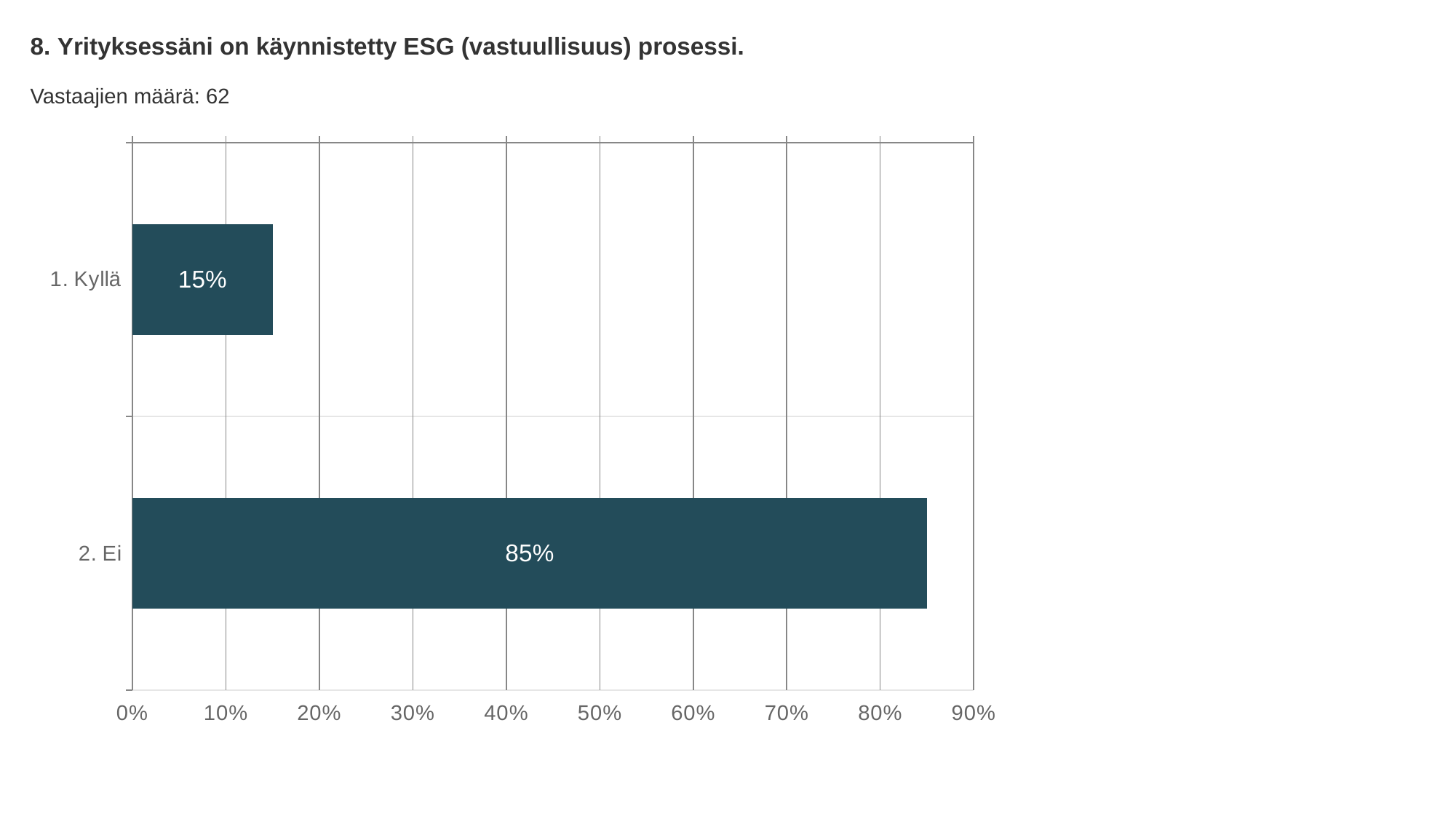
What is the difference between the values for "2. Ei" and "1. Kyllä"? 70% What is the value for "1. Kyllä"? 15% How many respondents (Vastaajien määrä) are reported on the slide? 62 Is the value for "1. Kyllä" greater or less than 20%? less How many categories are shown in the chart? 2 Which category has the lowest value? 1. Kyllä What is the value for "2. Ei"? 85% Which is larger, the value for "1. Kyllä" or the value for "2. Ei"? 2. Ei What is the total of the two values shown in the chart? 100% Is the value for "2. Ei" greater or less than 50%? greater Which category has the highest value? 2. Ei What kind of chart is shown on the slide? bar chart